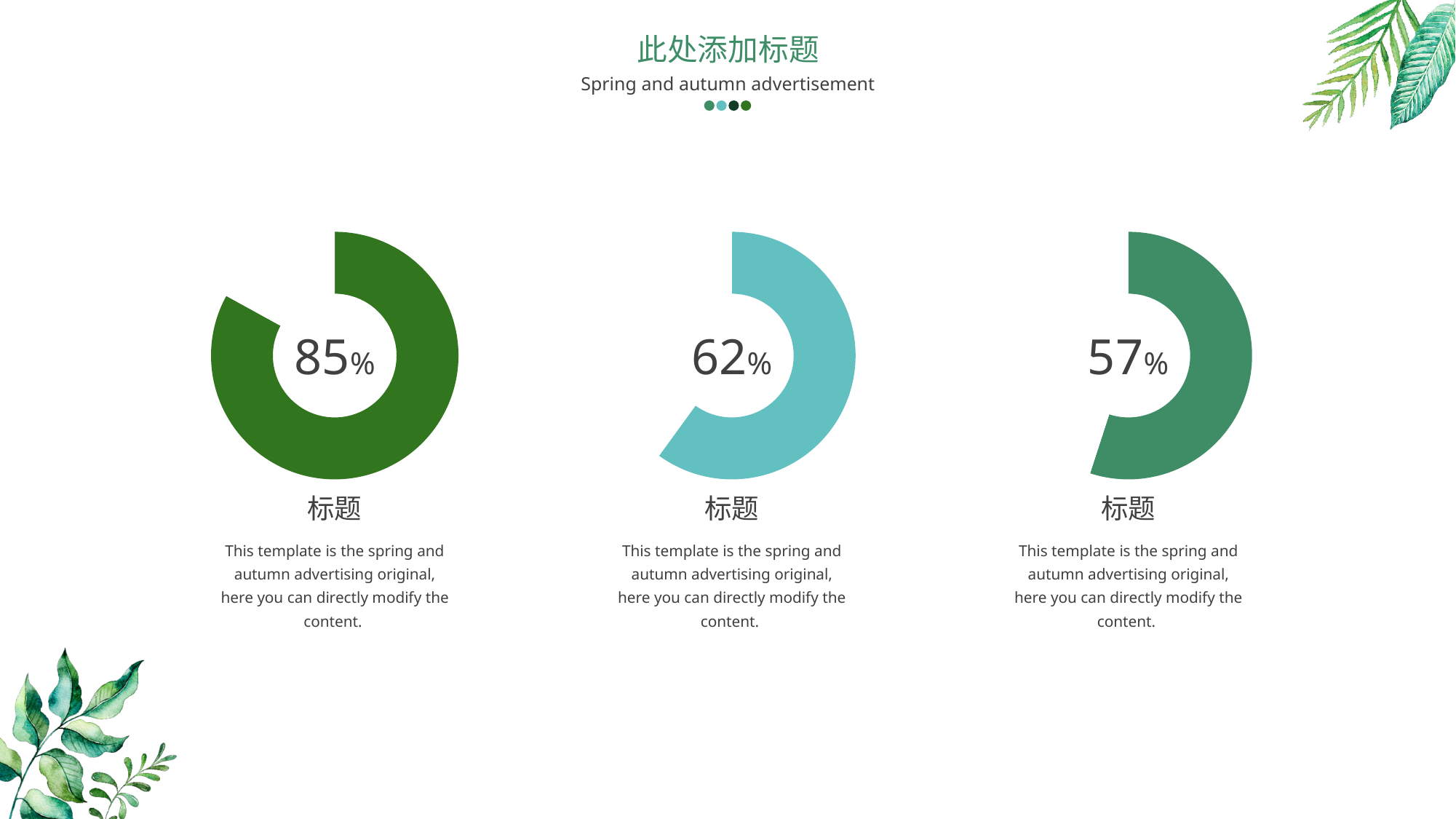
Which of the three donut charts shows the lowest percentage? The right chart (57%) What is the English subtitle shown under the slide title? Spring and autumn advertisement What value is shown in the left donut chart? 85% Which is larger, the value in the left donut chart or the value in the middle donut chart? The left chart (85%) What kind of chart is used to display the percentages on this slide? Donut chart What is the difference between the value in the left donut chart and the value in the right donut chart? 28% What colour is the filled portion of the middle donut chart? Teal (light blue-green) What value is shown in the right donut chart? 57% What value is shown in the middle donut chart? 62% How many donut charts are on the slide? 3 Which of the three donut charts shows the highest percentage? The left chart (85%) What is the difference between the value in the middle donut chart and the value in the right donut chart? 5%